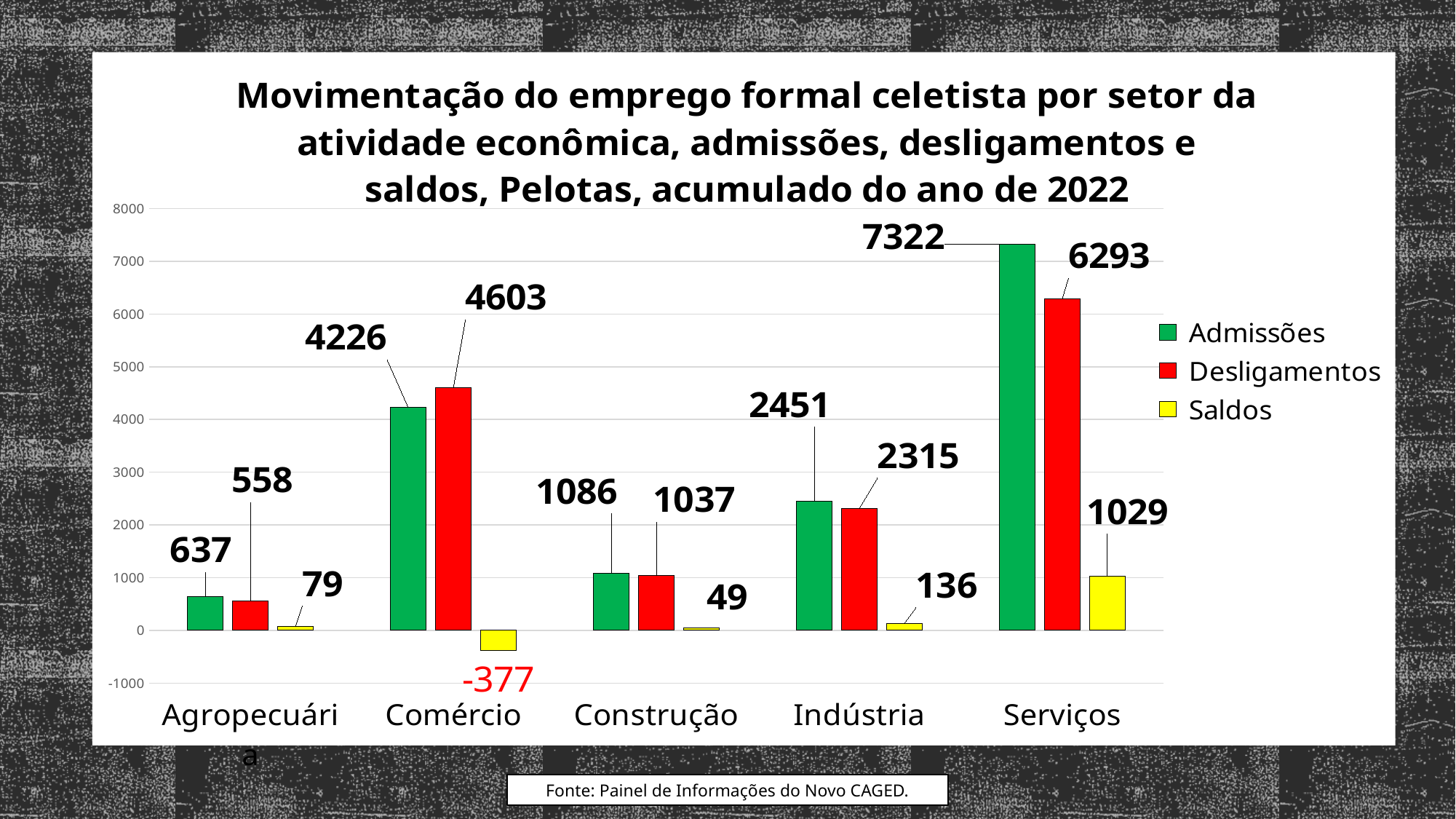
How many sectors are shown on the x axis? 5 What kind of chart is shown on the slide? Bar chart What is the Admissões value for Serviços? 7322 Which is larger for Comércio, Admissões or Desligamentos? Desligamentos What is the Desligamentos value for Comércio? 4603 How many series does the legend list? 3 Which sector has the highest Admissões value? Serviços What is the difference between Admissões and Desligamentos for Serviços? 1029 What is the Saldos value for Indústria? 136 Which sector has the lowest Saldos value? Comércio Which colour represents the Saldos series in the legend? Yellow What is the Saldos value for Comércio? -377